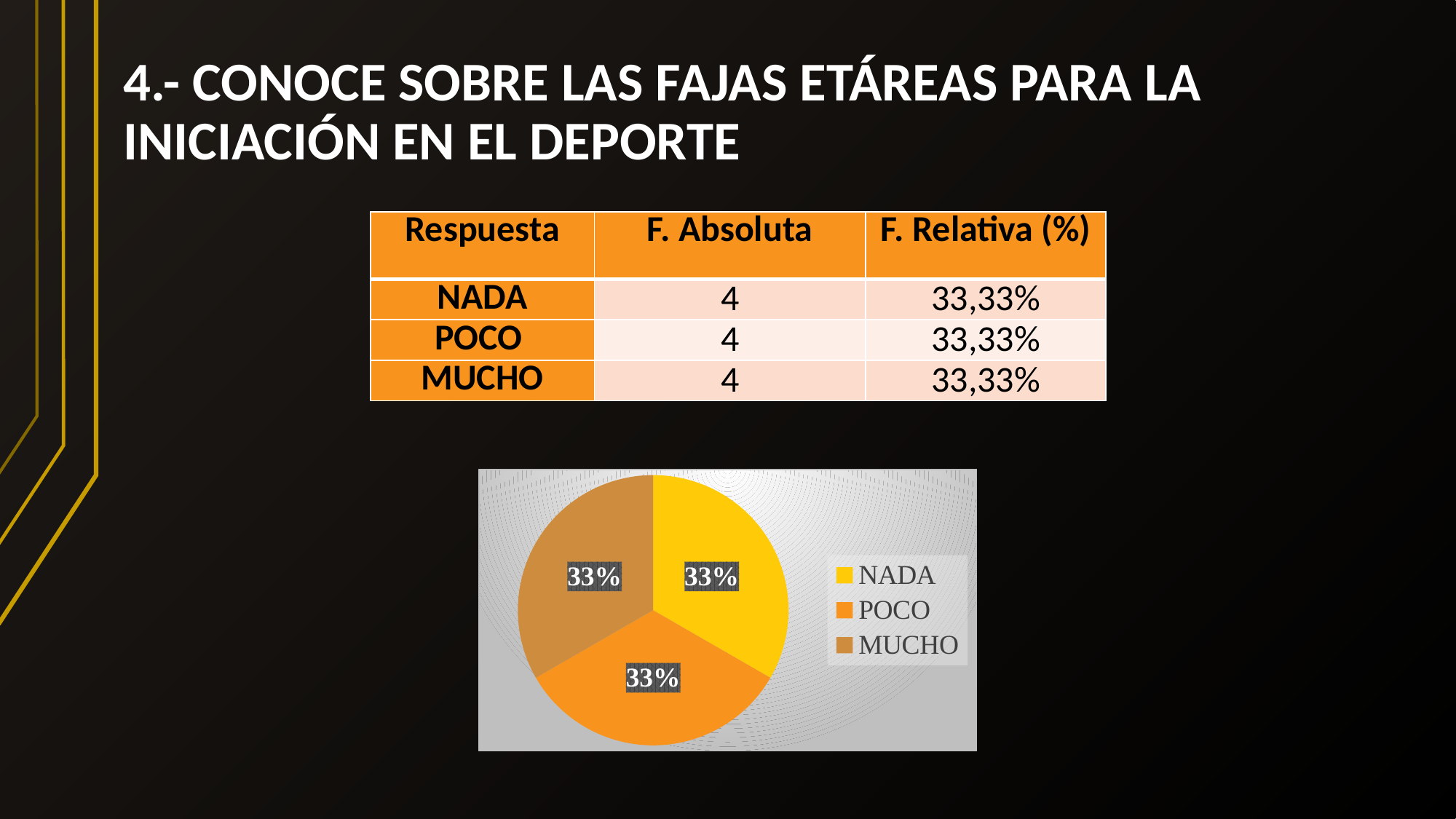
How many entries does the pie chart's legend list? 3 What kind of chart is shown on the slide? pie chart What percentage does the pie chart show for NADA? 33% How many slices does the pie chart have? 3 Which legend entry in the pie chart is shown in brown? MUCHO What percentage does the pie chart show for MUCHO? 33% Which legend entry in the pie chart is shown in yellow? NADA What percentage does the pie chart show for POCO? 33% Is the pie chart's share for POCO greater or less than 50%? less What is the difference between the pie chart's percentages for NADA and MUCHO? 0%